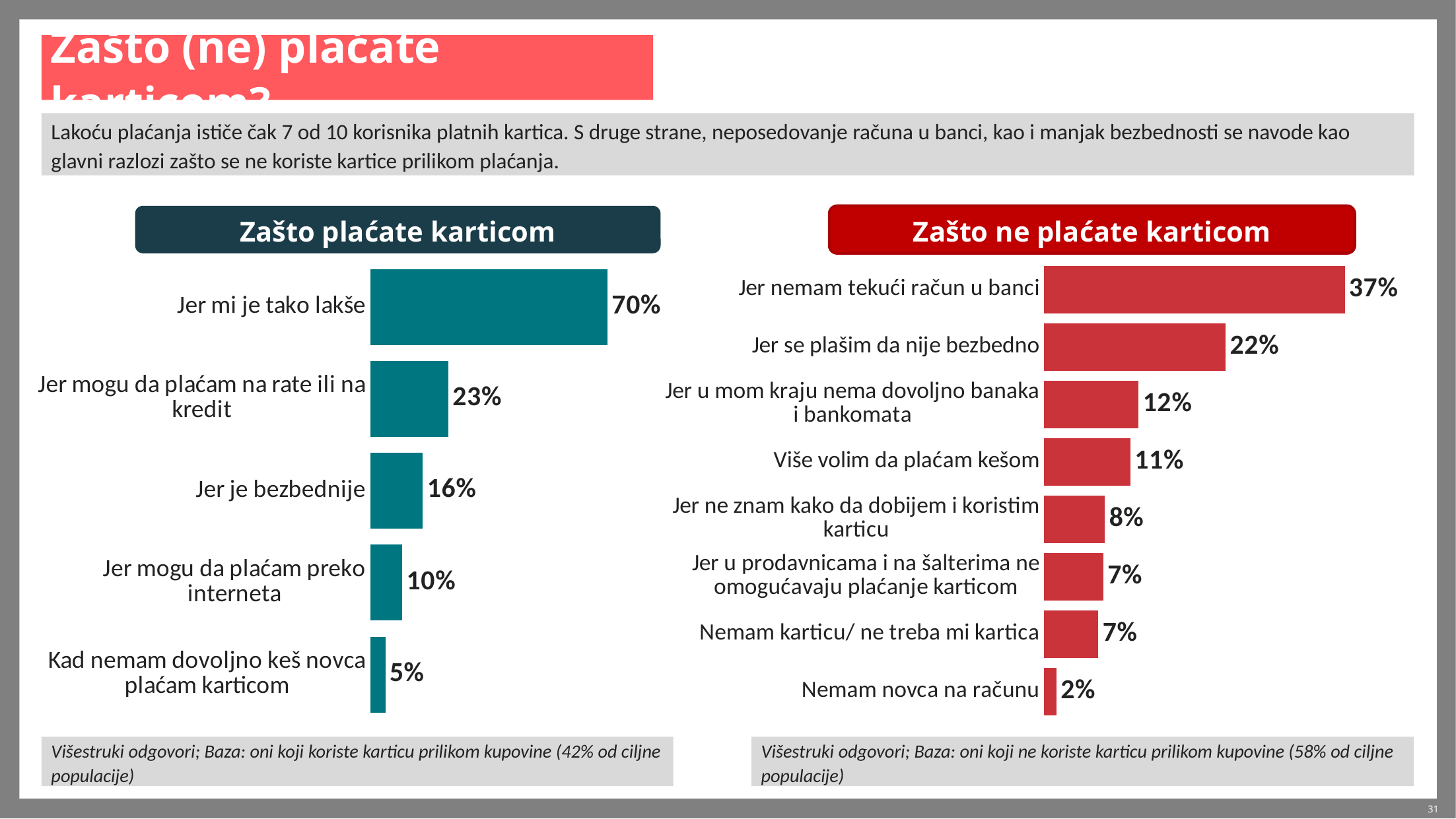
In the 'Zašto ne plaćate karticom' chart, what is the value for 'Jer nemam tekući račun u banci'? 37% In the 'Zašto ne plaćate karticom' chart, how many categories are shown? 8 In the 'Zašto ne plaćate karticom' chart, which category has the lowest value? Nemam novca na računu In the 'Zašto plaćate karticom' chart, how many categories are shown? 5 In the 'Zašto ne plaćate karticom' chart, what is the difference between 'Jer se plašim da nije bezbedno' and 'Jer u mom kraju nema dovoljno banaka i bankomata'? 10% In the 'Zašto plaćate karticom' chart, what is the value for 'Jer mi je tako lakše'? 70% What type of chart is the 'Zašto ne plaćate karticom' chart? Bar chart In the 'Zašto ne plaćate karticom' chart, which category has the highest value? Jer nemam tekući račun u banci In the 'Zašto plaćate karticom' chart, which category has the lowest value? Kad nemam dovoljno keš novca plaćam karticom In the 'Zašto plaćate karticom' chart, what is the difference between 'Jer mi je tako lakše' and 'Jer mogu da plaćam na rate ili na kredit'? 47% In the 'Zašto ne plaćate karticom' chart, what is the value for 'Više volim da plaćam kešom'? 11% In the 'Zašto plaćate karticom' chart, what is the value for 'Jer je bezbednije'? 16%